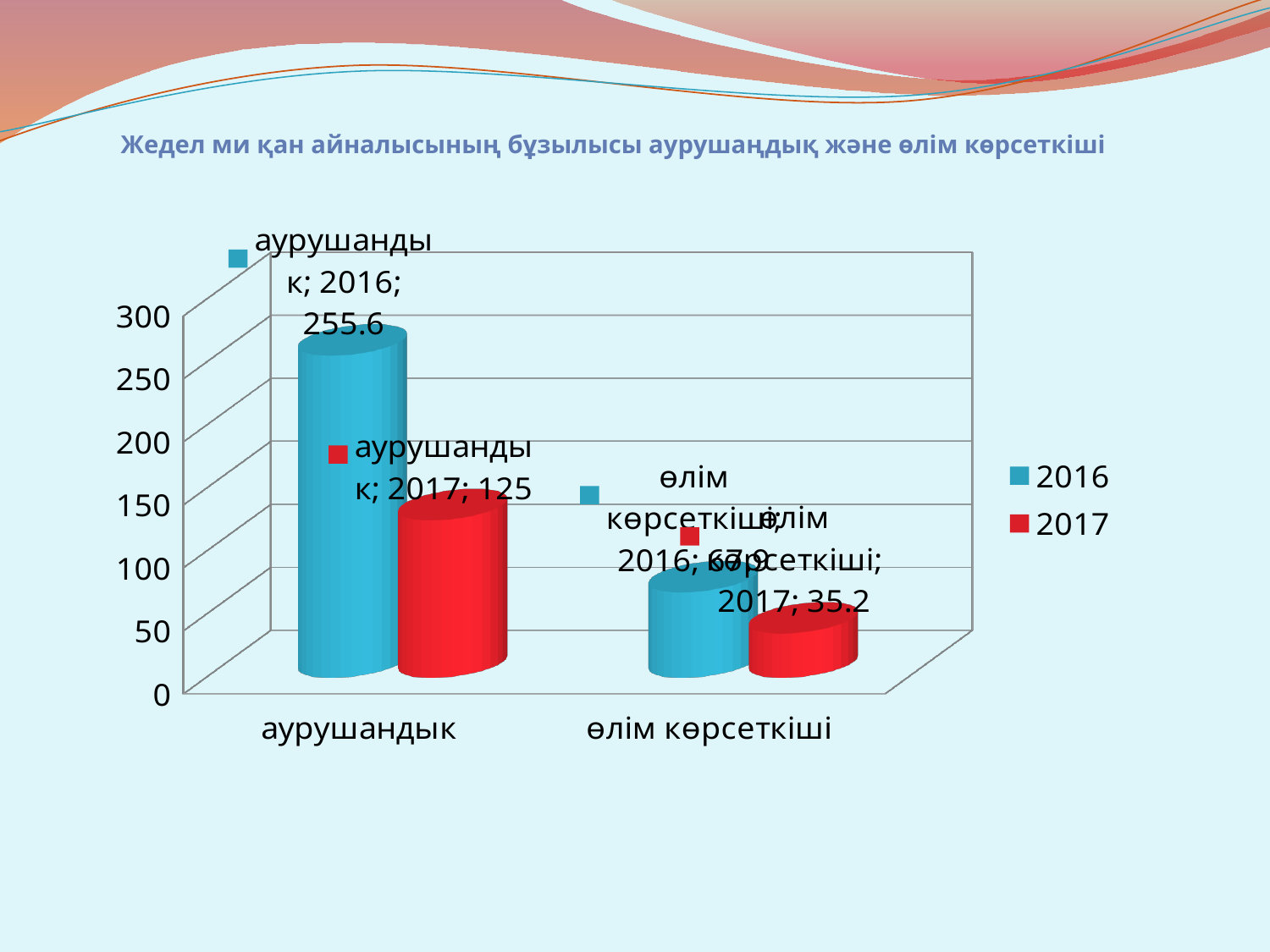
What is the value for өлім көрсеткіші in 2017? 35.2 How many categories are shown on the x axis? 2 What is the difference between the 2016 and 2017 values for аурушандык? 130.6 Which series is shown in red in the legend? 2017 Which category has the lowest value in the 2017 series? өлім көрсеткіші What is the value for аурушандык in 2017? 125 For өлім көрсеткіші, which year has the larger value, 2016 or 2017? 2016 How many series does the legend list? 2 What kind of chart is shown on the slide? bar chart Is the 2016 value for өлім көрсеткіші greater or less than 50? greater Which category has the highest value in the 2016 series? аурушандык What is the value for аурушандык in 2016? 255.6